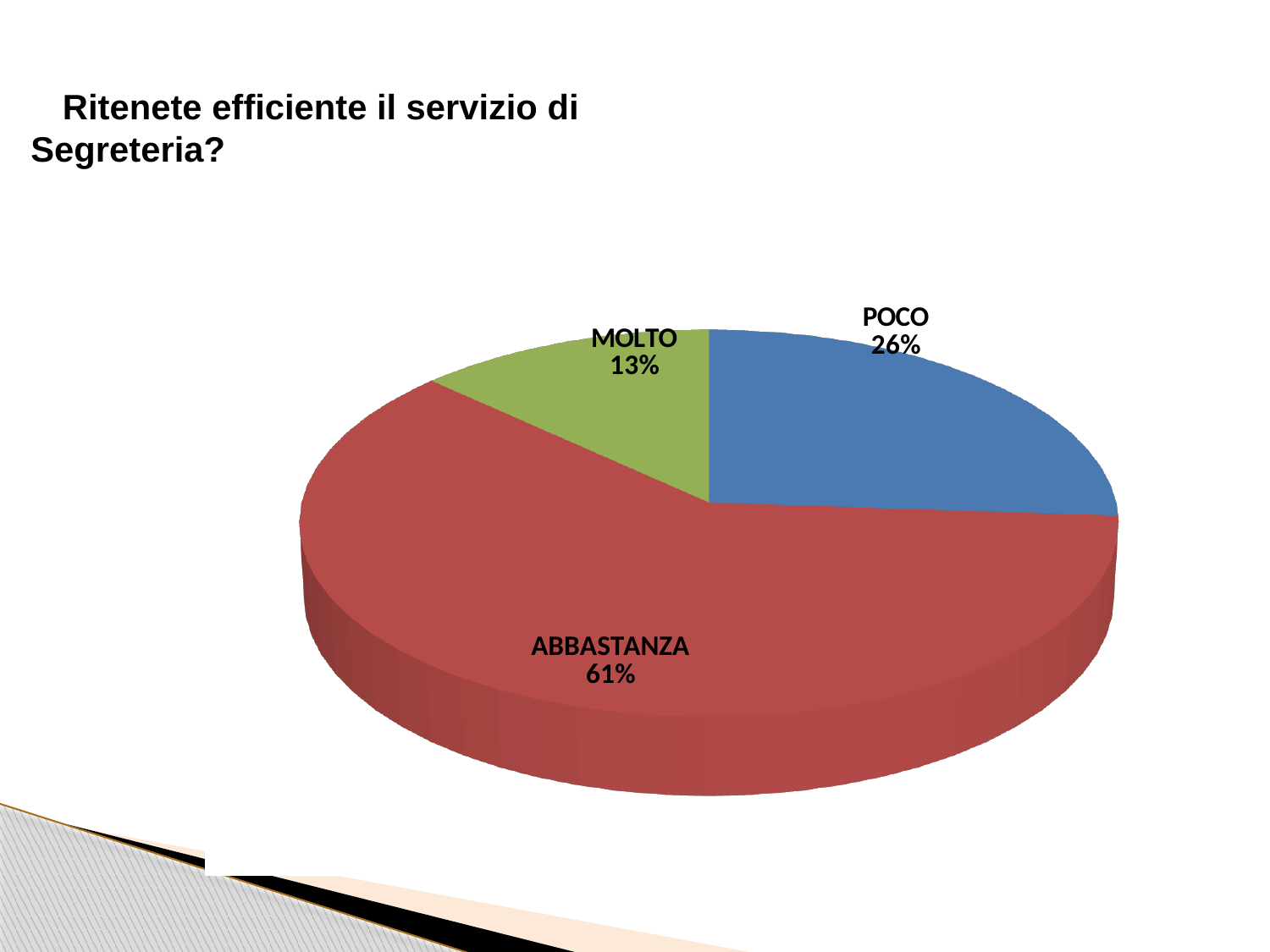
Which category has the largest slice of the pie? ABBASTANZA Which is larger, the POCO slice or the MOLTO slice? POCO What is the difference in percentage points between ABBASTANZA and POCO? 35 What kind of chart is shown on the slide? pie chart What question is the chart on the slide about? Ritenete efficiente il servizio di Segreteria? What share of the pie does POCO represent? 26% What share of the pie does ABBASTANZA represent? 61% How many slices does the pie chart have? 3 What is the difference in percentage points between POCO and MOLTO? 13 What colour is the ABBASTANZA slice? red Which category has the smallest slice of the pie? MOLTO What share of the pie does MOLTO represent? 13%